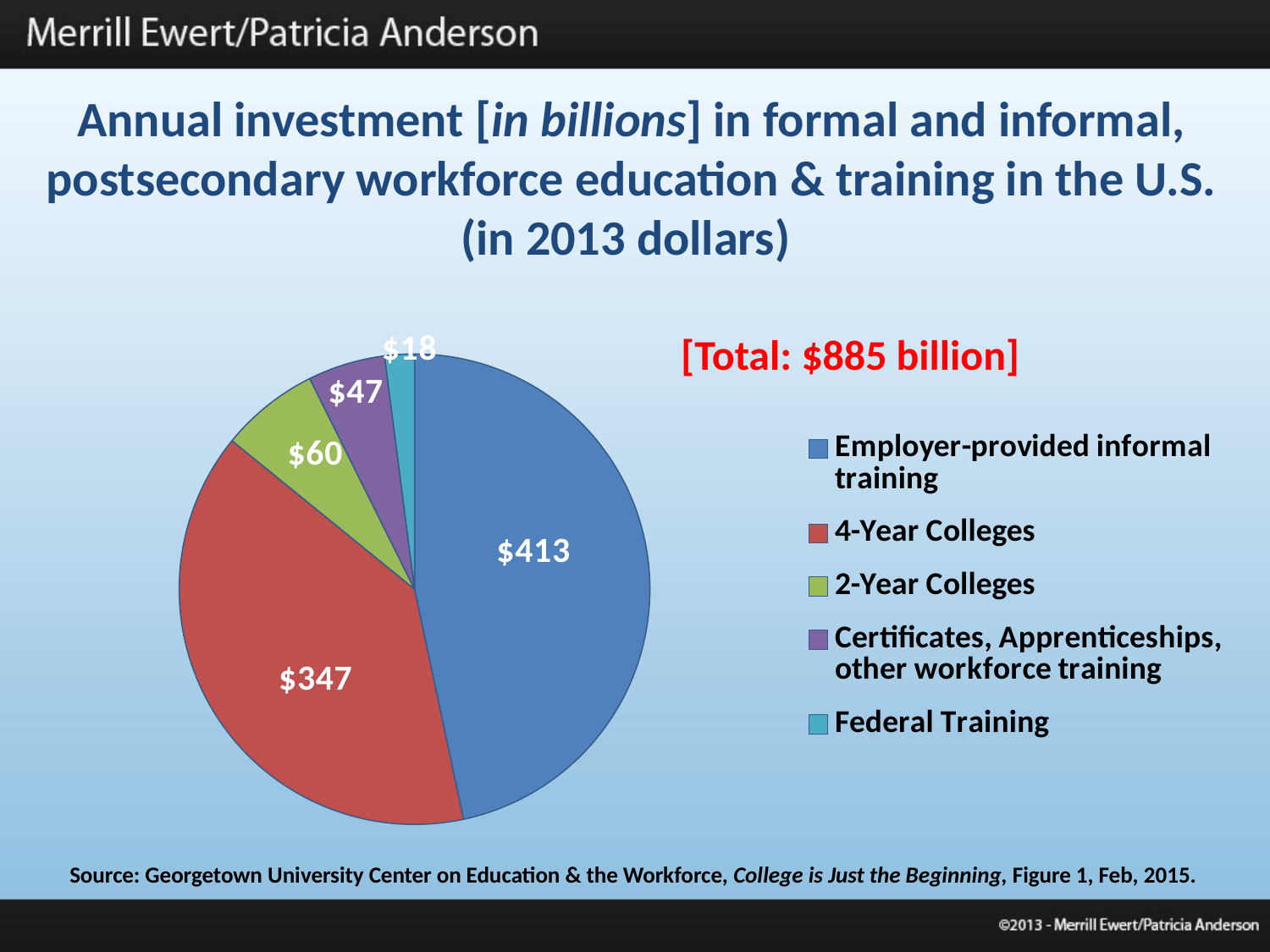
What type of chart is shown on the slide? Pie chart Which category has the smallest slice of the pie? Federal Training Which is larger, the value for 2-Year Colleges or the value for Certificates, Apprenticeships, other workforce training? 2-Year Colleges What is the annual investment value for 4-Year Colleges? $347 How many categories does the pie chart have? 5 What is the annual investment value for Federal Training? $18 What total is stated on the slide for the annual investment? $885 billion What is the difference between the values for Employer-provided informal training and 4-Year Colleges? $66 What is the annual investment value for Employer-provided informal training? $413 Which category has the largest slice of the pie? Employer-provided informal training What is the annual investment value for 2-Year Colleges? $60 What colour is the slice for 4-Year Colleges? Red